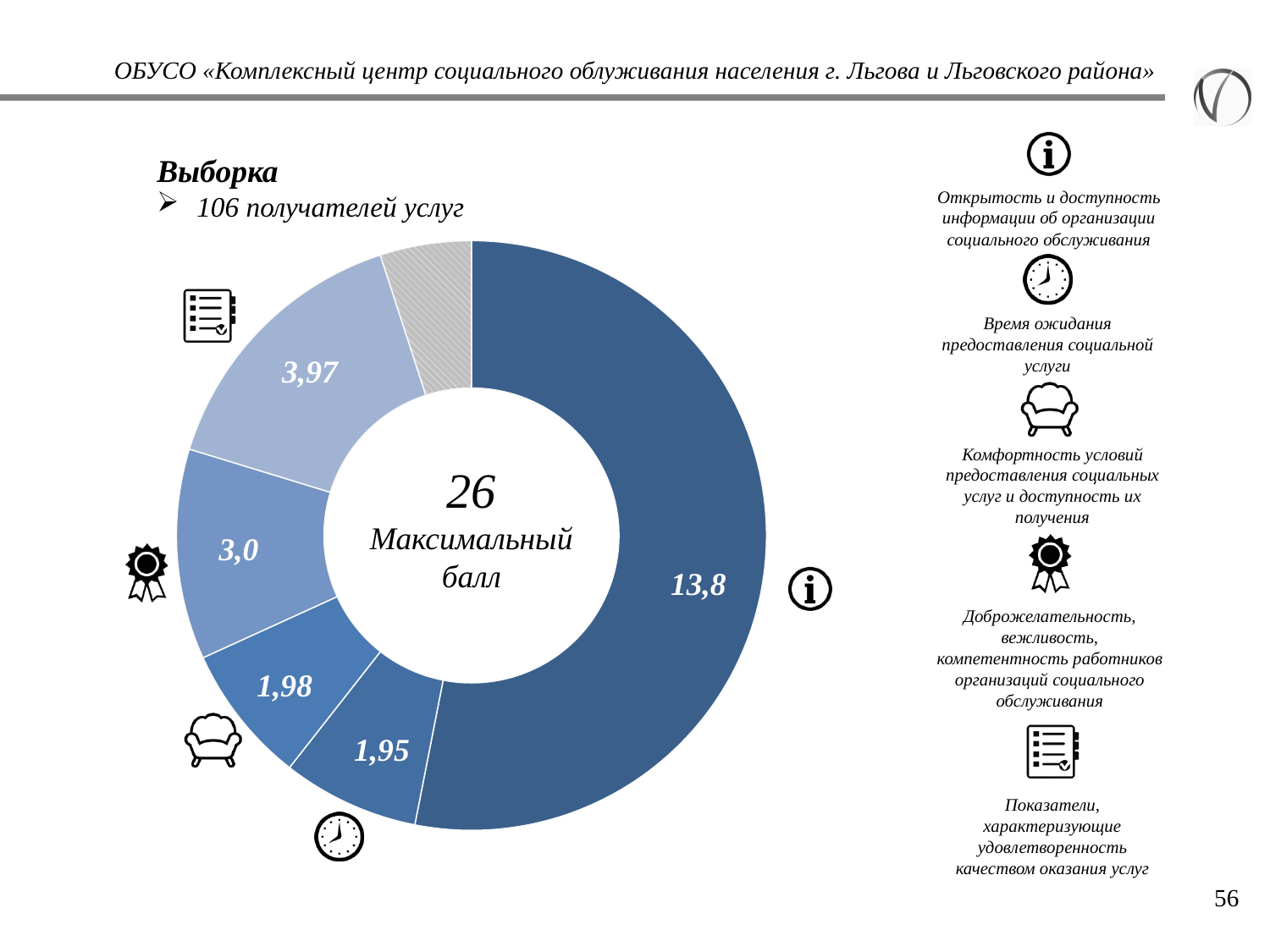
What value is printed on the segment marked with the clock icon (Время ожидания предоставления социальной услуги)? 1,95 How many segments of the doughnut chart have a printed value label? 5 What is the difference between the largest labelled value (13,8) and the value for the checklist-icon segment (3,97)? 9,83 What is the difference between the value for the checklist-icon segment (3,97) and the medal-icon segment (3,0)? 0,97 What value is printed on the largest segment of the doughnut chart? 13,8 Which is larger: the value for the medal-icon segment or the value for the armchair-icon segment? The medal-icon segment (3,0) What type of chart is shown on the slide? Doughnut chart What value is printed on the segment marked with the medal icon (Доброжелательность, вежливость, компетентность работников)? 3,0 What value is printed on the segment marked with the armchair icon (Комфортность условий предоставления социальных услуг)? 1,98 Which criterion has the highest value in the doughnut chart? Открытость и доступность информации об организации социального обслуживания (13,8) What value is printed on the segment marked with the checklist icon (Показатели, характеризующие удовлетворенность качеством оказания услуг)? 3,97 What maximum score is shown in the centre of the doughnut chart? 26